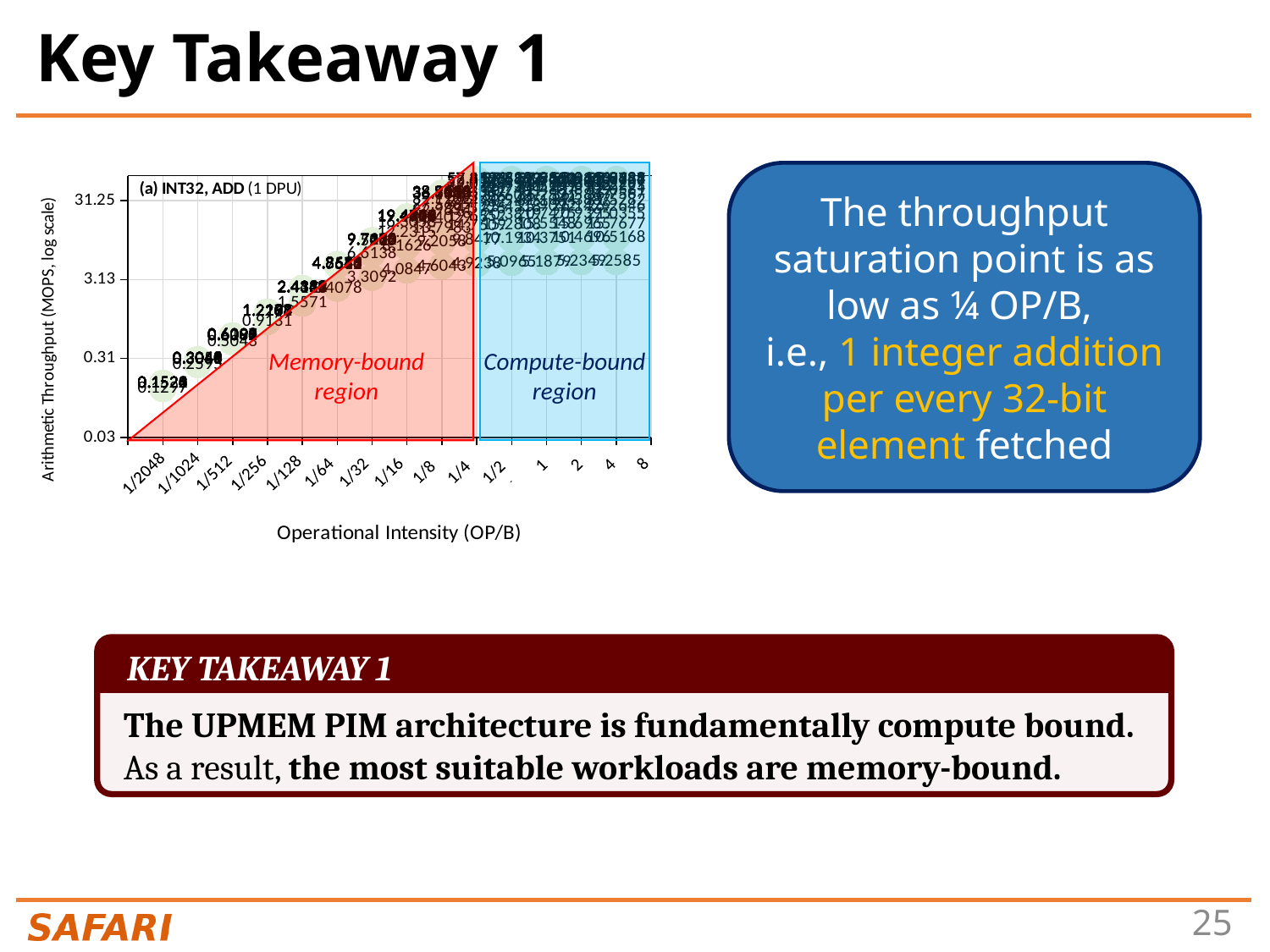
Is the arithmetic throughput at operational intensity 8 greater or less than 3.13 MOPS? greater What kind of chart is shown on the slide? scatter chart What are the two shaded regions in the chart labelled? Memory-bound region and Compute-bound region How does arithmetic throughput change as operational intensity increases from 1/2048 to 1/4 in the chart? It rises Which operational intensity has the lowest arithmetic throughput in the chart? 1/2048 Is the arithmetic throughput at operational intensity 1/128 greater or less than 0.31 MOPS? greater What is the title shown inside the chart? (a) INT32, ADD (1 DPU) How many operational intensity values are marked on the x axis of the chart? 15 Is the arithmetic throughput at operational intensity 1/2048 greater or less than 0.31 MOPS? less Which has the higher arithmetic throughput: operational intensity 8 or operational intensity 1/2048? 8